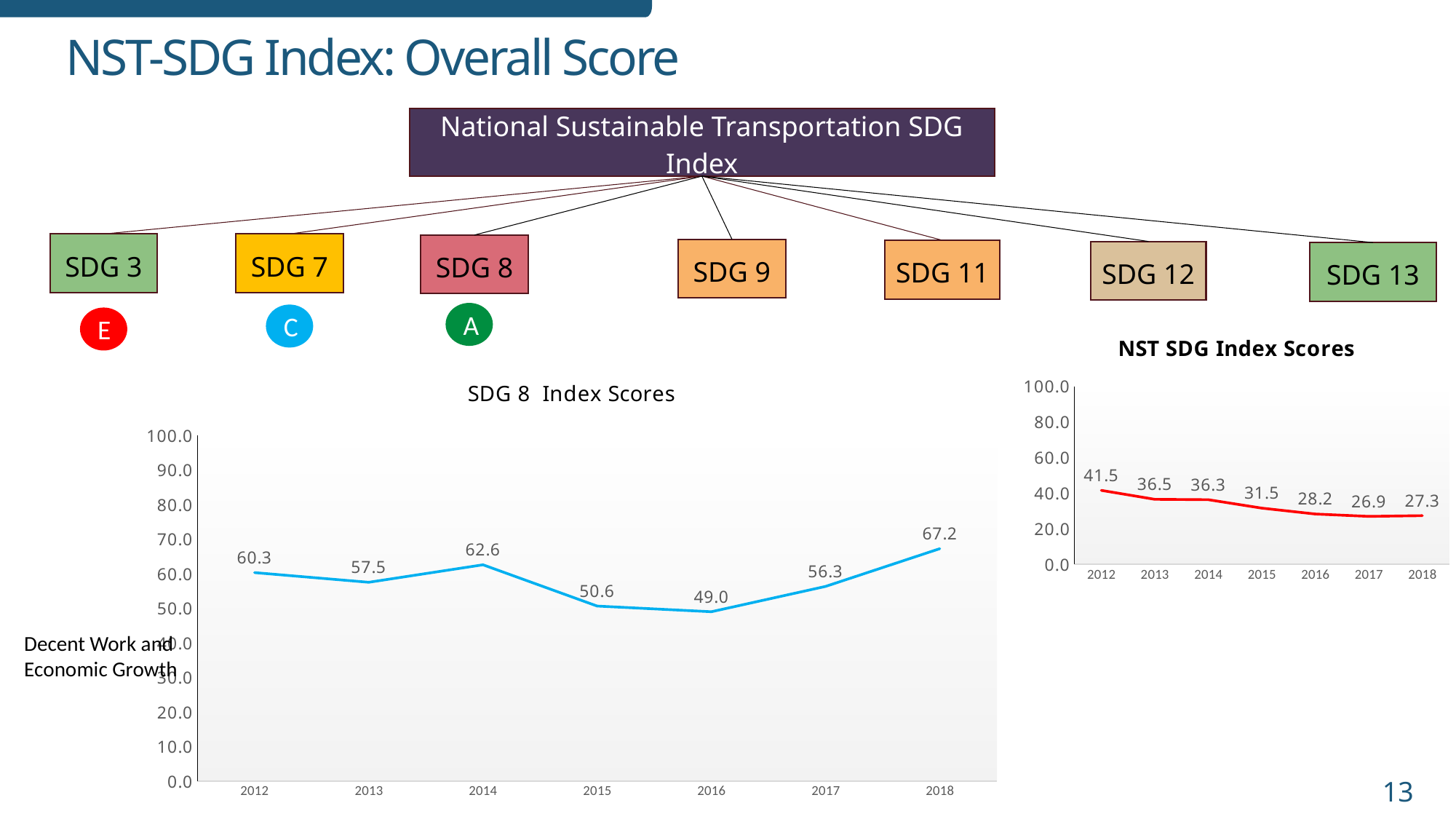
In the 'NST SDG Index Scores' chart, is the value for 2015 larger than the value for 2016? Yes In the 'NST SDG Index Scores' chart, do the values generally rise or fall from 2012 to 2018? fall In the 'NST SDG Index Scores' chart, which year has the lowest value? 2017 What kind of chart is the 'SDG 8 Index Scores' chart? line chart In the 'SDG 8 Index Scores' chart, how many years are plotted? 7 In the 'SDG 8 Index Scores' chart, what is the value for 2014? 62.6 In the 'SDG 8 Index Scores' chart, which year has the highest value? 2018 What colour is the line in the 'NST SDG Index Scores' chart? red In the 'NST SDG Index Scores' chart, what is the difference between the 2012 value and the 2018 value? 14.2 In the 'SDG 8 Index Scores' chart, which year has the lowest value? 2016 In the 'NST SDG Index Scores' chart, what is the value for 2012? 41.5 In the 'SDG 8 Index Scores' chart, what is the difference between the 2018 value and the 2016 value? 18.2